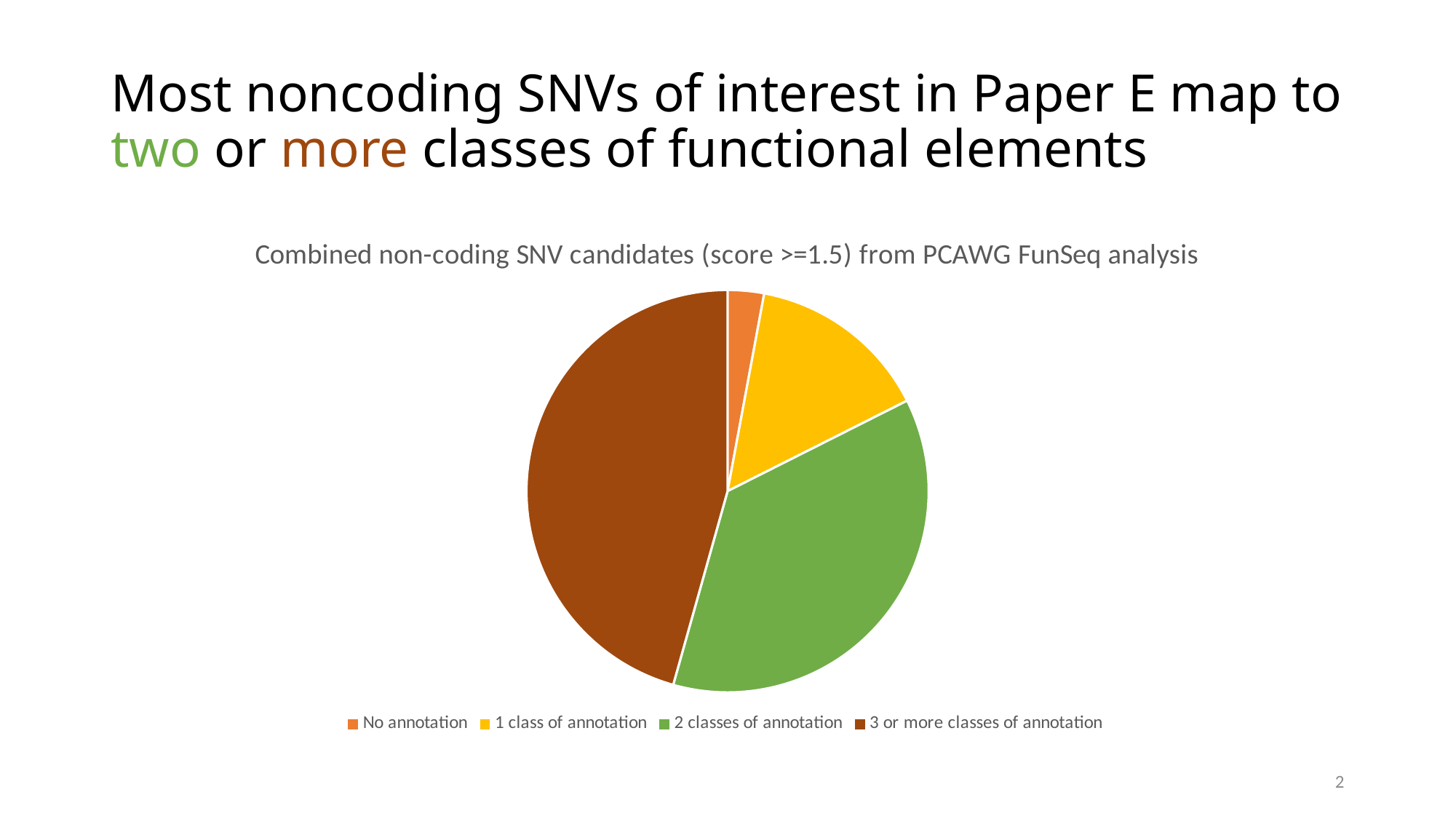
Which slice is larger: '1 class of annotation' or '2 classes of annotation'? 2 classes of annotation Which category has the smallest slice of the pie chart? No annotation What is the title of the pie chart? Combined non-coding SNV candidates (score >=1.5) from PCAWG FunSeq analysis How many slices does the pie chart have? 4 What colour is the '2 classes of annotation' slice in the pie chart? green Which slice is larger: 'No annotation' or '1 class of annotation'? 1 class of annotation Which category has the largest slice of the pie chart? 3 or more classes of annotation How many entries does the legend of the pie chart list? 4 What kind of chart is shown on the slide? pie chart Which slice is larger: '1 class of annotation' or '3 or more classes of annotation'? 3 or more classes of annotation